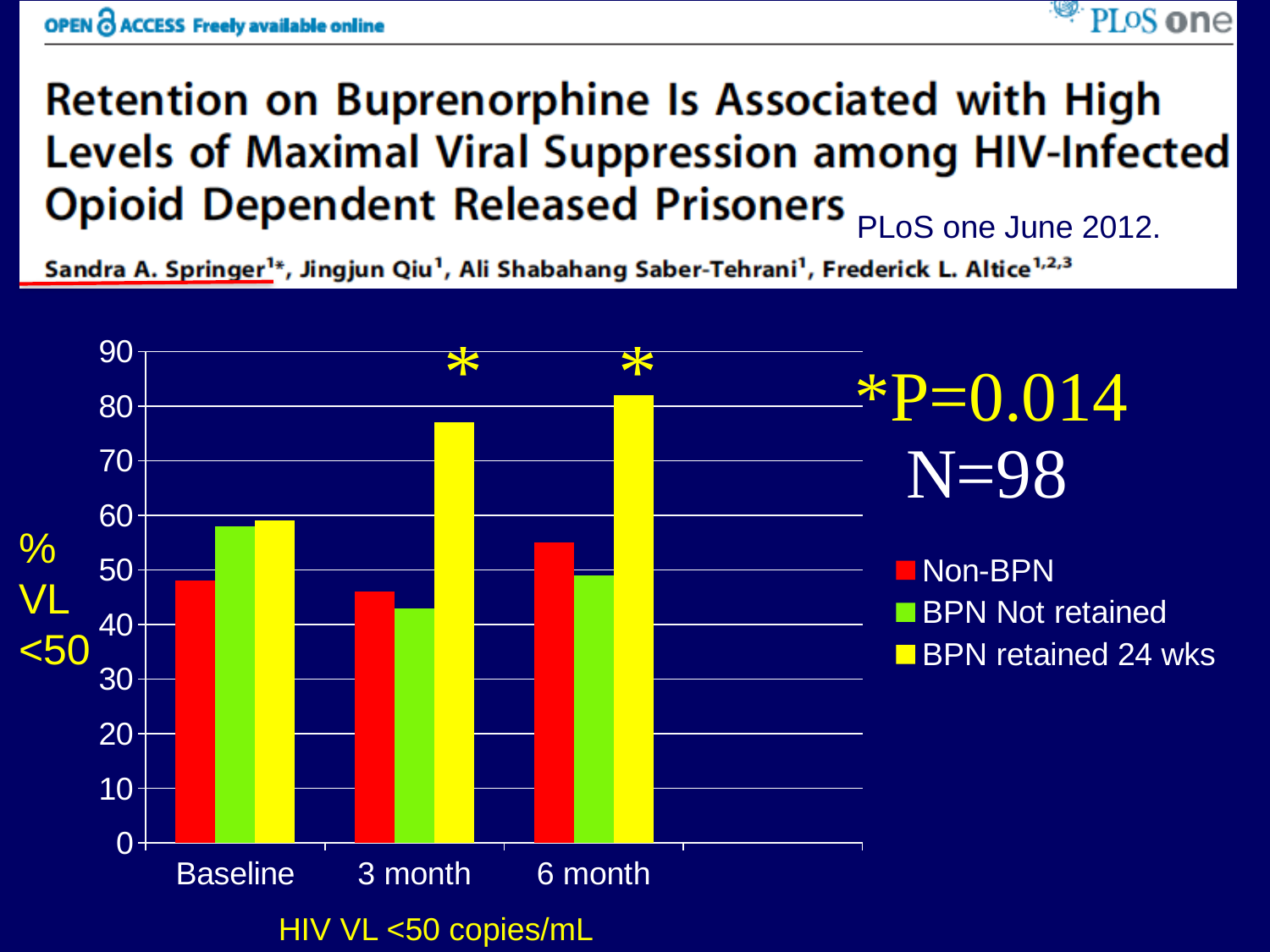
Is the value for BPN Not retained at 3 month greater or less than 50? less At 6 month, which is larger: Non-BPN or BPN Not retained? Non-BPN At Baseline, which is larger: Non-BPN or BPN retained 24 wks? BPN retained 24 wks What kind of chart is shown on the slide? bar chart At 6 month, which series has the highest value? BPN retained 24 wks How many series does the legend list? 3 At 6 month, which series has the lowest value? BPN Not retained How many time-point categories are shown on the x axis? 3 What colour represents BPN retained 24 wks in the legend? yellow Is the value for BPN retained 24 wks at 3 month greater or less than 70? greater Does the BPN retained 24 wks series rise or fall from Baseline to 6 month? rise Is the value for BPN retained 24 wks at 6 month greater or less than 70? greater